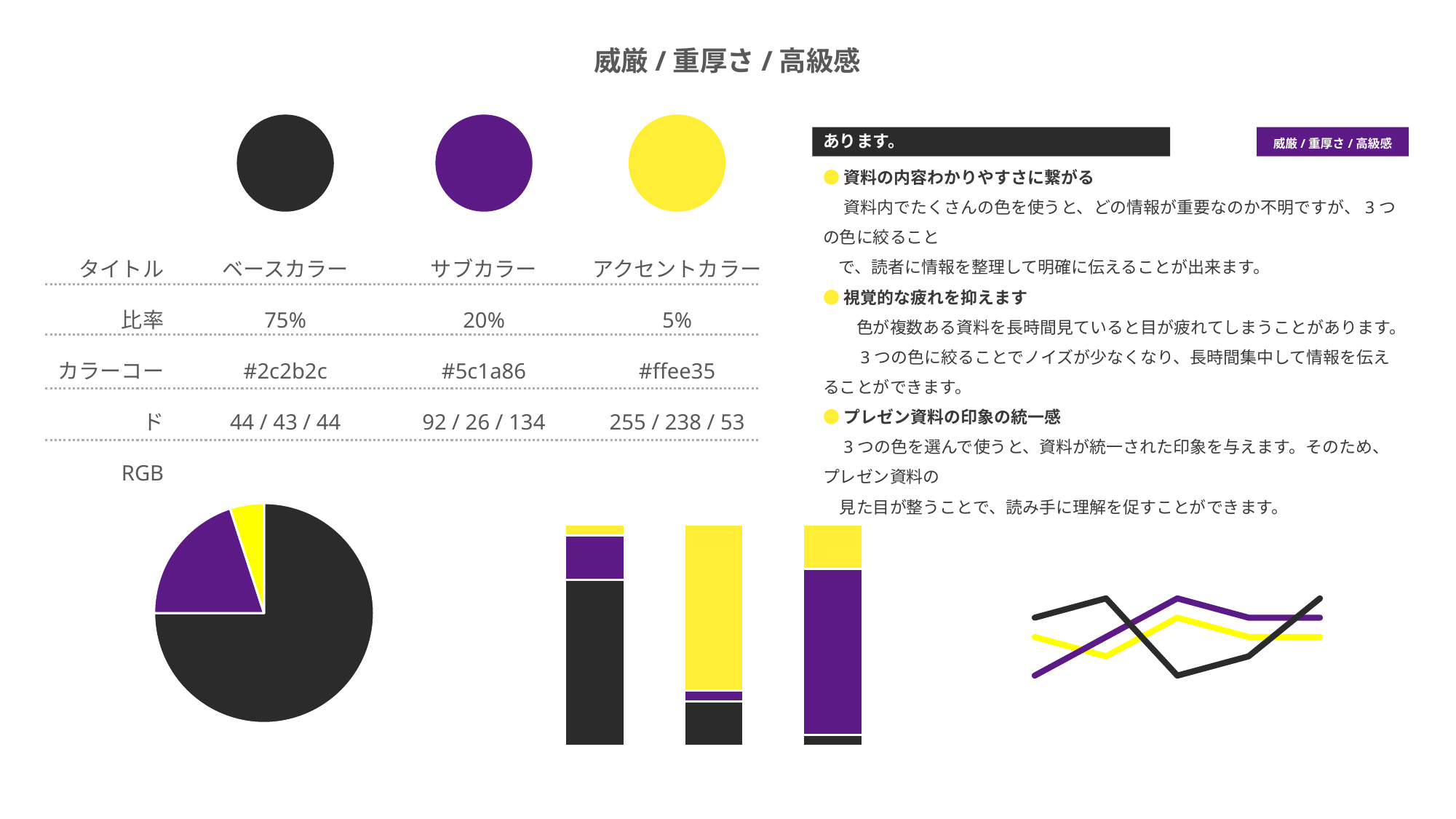
In the pie chart at the bottom left, how many slices are there? 3 In the bar chart in the bottom centre, which bar has the largest black segment? the left bar In the pie chart at the bottom left, which colour slice is the smallest? yellow In the bar chart in the bottom centre, which bar has the largest yellow segment? the middle bar What kind of chart is shown in the bottom centre of the slide? bar chart In the line chart at the bottom right, how many lines are plotted? 3 In the bar chart in the bottom centre, how many bars are there? 3 In the bar chart in the bottom centre, is the black segment larger in the left bar or the right bar? the left bar In the bar chart in the bottom centre, which bar has the largest purple segment? the right bar What kind of chart is shown at the bottom left of the slide? pie chart What kind of chart is shown at the bottom right of the slide? line chart